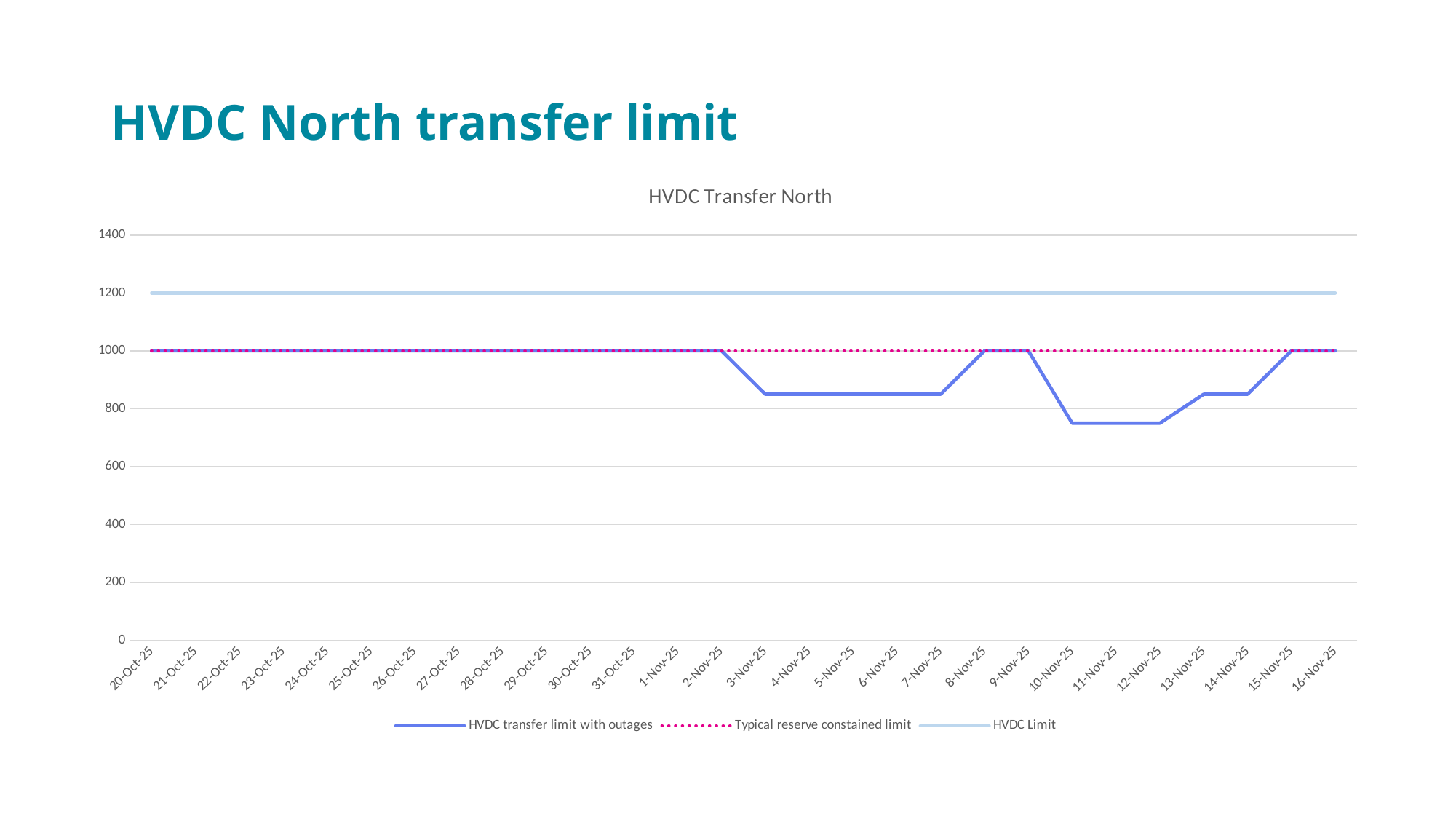
What is the value of the HVDC transfer limit with outages series on 20-Oct-25? 1000 Is the value of the HVDC transfer limit with outages on 4-Nov-25 greater or less than 800? greater What is the value of the HVDC Limit series on 20-Oct-25? 1200 What is the title of the chart? HVDC Transfer North What is the difference between the HVDC Limit and the Typical reserve constrained limit on 25-Oct-25? 200 Which is larger on 10-Nov-25: the HVDC Limit or the HVDC transfer limit with outages? HVDC Limit Is the value of the HVDC transfer limit with outages on 11-Nov-25 greater or less than 800? less Which series has the highest values across the chart? HVDC Limit How many dates are shown on the x axis? 28 How many series does the legend list? 3 What type of chart is shown on the slide? line chart What is the value of the Typical reserve constrained limit series on 1-Nov-25? 1000